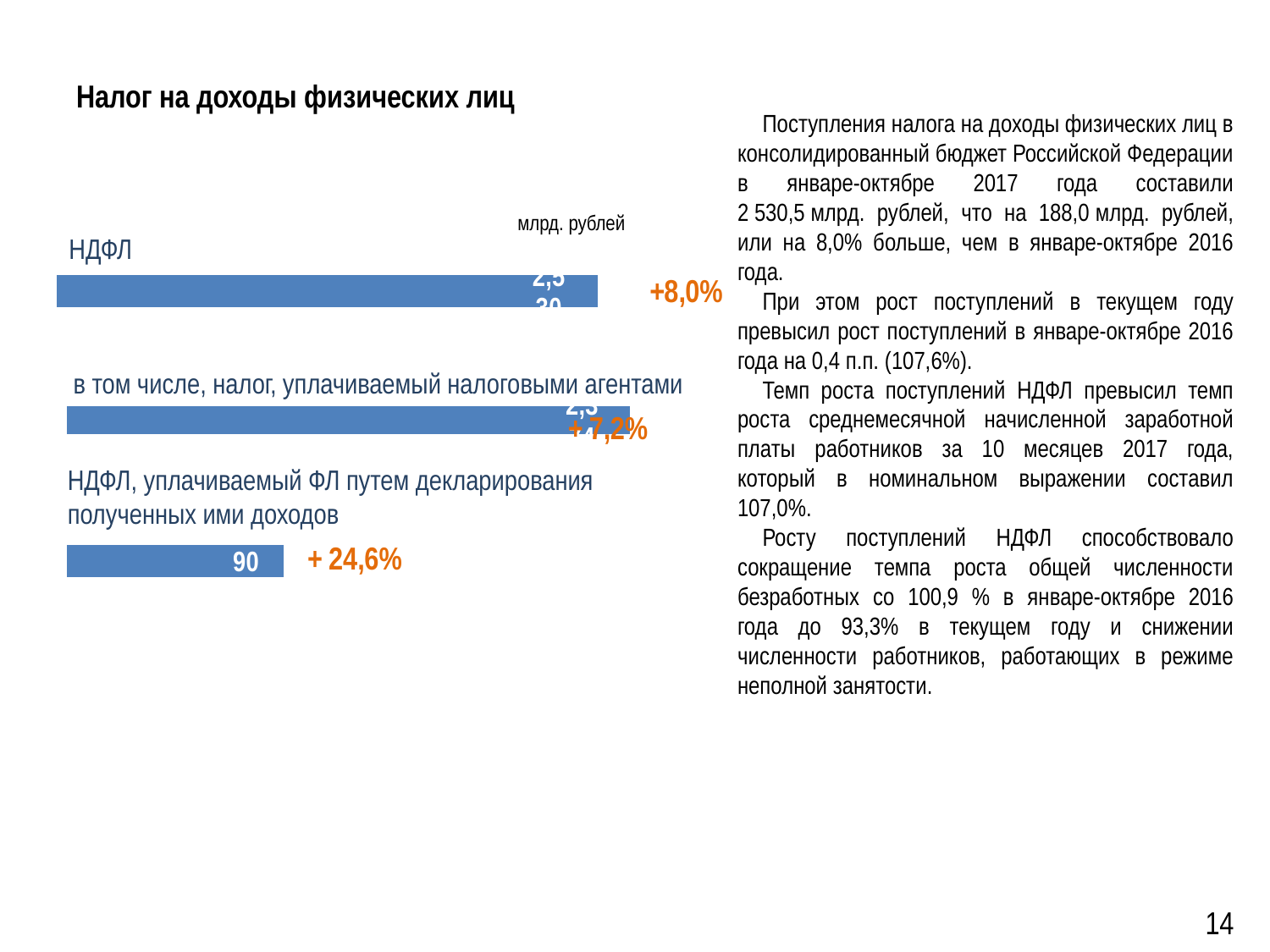
What kind of chart is used on the slide to show the НДФЛ figures? bar chart In what units are the bar values given, according to the label above the first bar? млрд. рублей How many bars are shown on the slide? 3 Which bar is longer: 'НДФЛ' or 'НДФЛ, уплачиваемый ФЛ путем декларирования полученных ими доходов'? НДФЛ What is the title of the slide containing the bar charts? Налог на доходы физических лиц Which bar is the shortest on the slide? НДФЛ, уплачиваемый ФЛ путем декларирования полученных ими доходов What growth percentage is printed next to the 'НДФЛ' bar? +8,0% What growth percentage is printed next to the bar for 'НДФЛ, уплачиваемый ФЛ путем декларирования полученных ими доходов'? + 24,6% What value is printed on the bar for 'НДФЛ, уплачиваемый ФЛ путем декларирования полученных ими доходов'? 90 Which bar is longer: 'в том числе, налог, уплачиваемый налоговыми агентами' or 'НДФЛ, уплачиваемый ФЛ путем декларирования полученных ими доходов'? в том числе, налог, уплачиваемый налоговыми агентами What growth percentage is printed next to the bar for 'в том числе, налог, уплачиваемый налоговыми агентами'? + 7,2% Which bar is the longest on the slide? НДФЛ